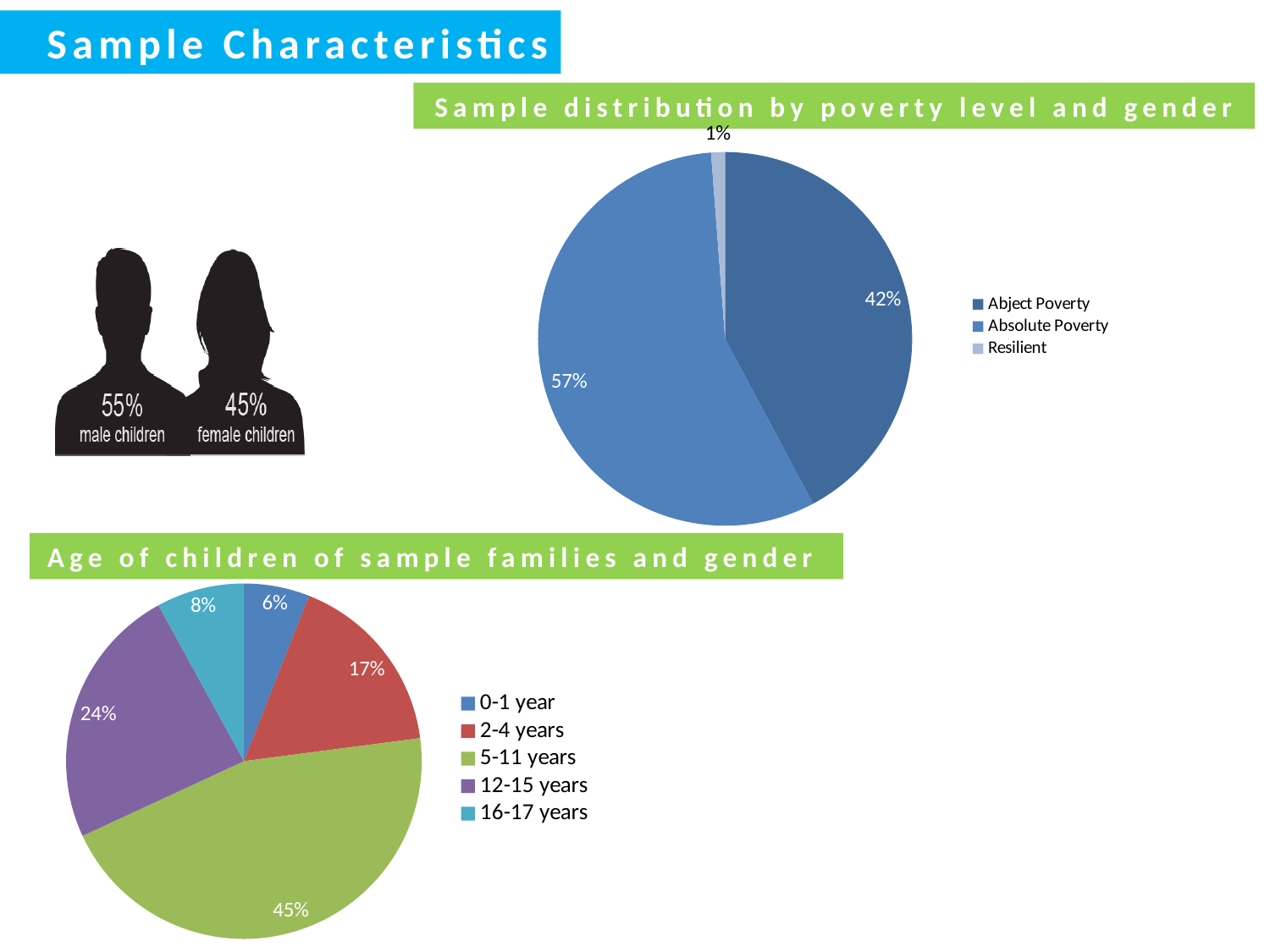
In the 'Sample distribution by poverty level and gender' pie chart, how many categories does the legend list? 3 In the 'Age of children of sample families and gender' pie chart, which is larger: 2-4 years or 16-17 years? 2-4 years In the 'Age of children of sample families and gender' pie chart, which age group has the largest share? 5-11 years In the 'Age of children of sample families and gender' pie chart, what share is 5-11 years? 45% What kind of chart is the 'Age of children of sample families and gender' chart? Pie chart In the 'Age of children of sample families and gender' pie chart, what share is 12-15 years? 24% In the 'Sample distribution by poverty level and gender' pie chart, what share is Abject Poverty? 42% In the 'Age of children of sample families and gender' pie chart, which age group has the smallest share? 0-1 year In the 'Sample distribution by poverty level and gender' pie chart, what is the difference between the Absolute Poverty and Abject Poverty shares? 15% In the 'Sample distribution by poverty level and gender' pie chart, what share is Absolute Poverty? 57% In the 'Age of children of sample families and gender' pie chart, how many age groups does the legend list? 5 In the 'Sample distribution by poverty level and gender' pie chart, which category has the smallest share? Resilient